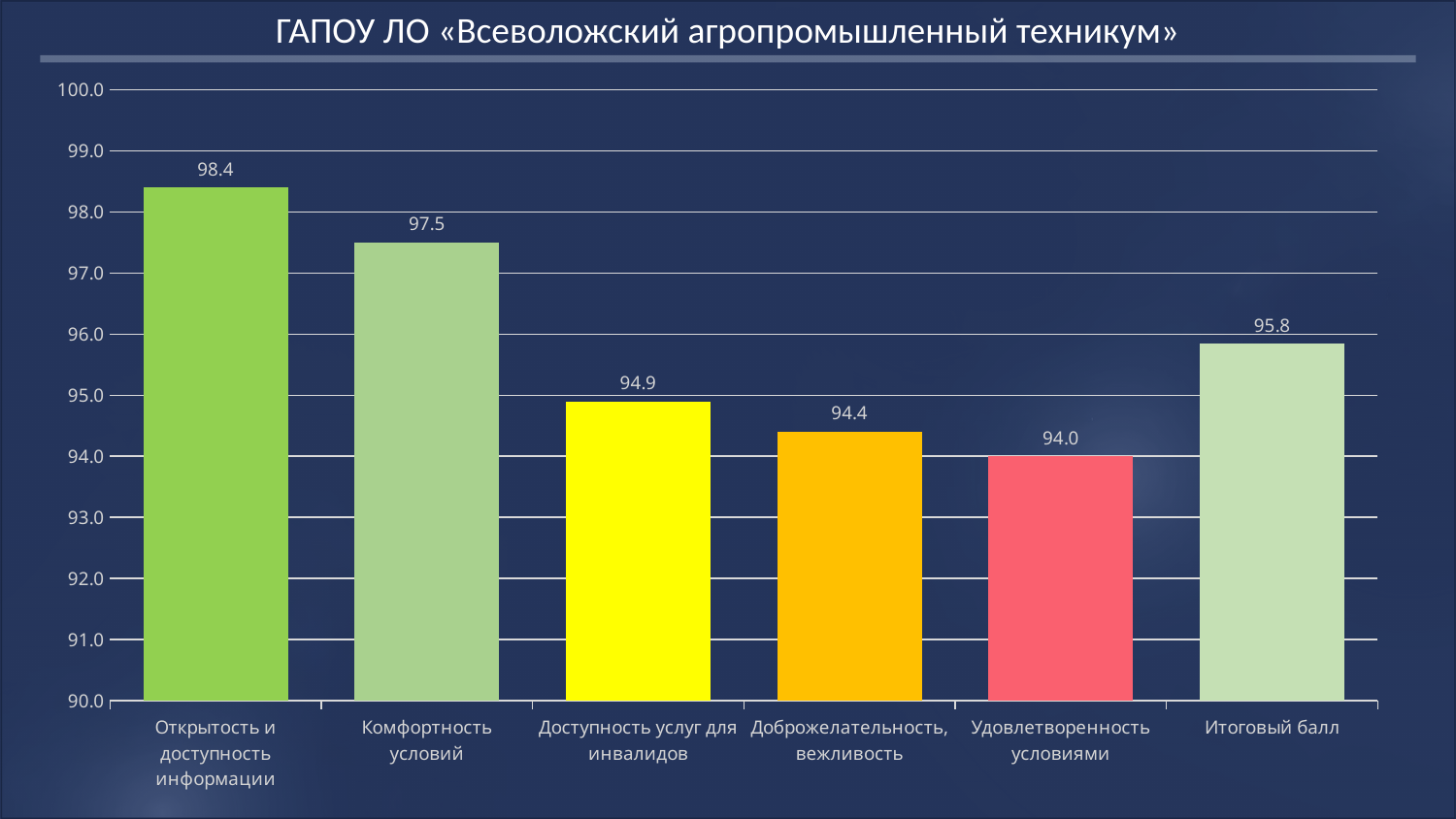
How many categories are shown on the chart? 6 What kind of chart is shown on the slide? Bar chart Which category has the highest value? Открытость и доступность информации What is the value for «Открытость и доступность информации»? 98.4 What is the title of the chart? ГАПОУ ЛО «Всеволожский агропромышленный техникум» What is the value for «Комфортность условий»? 97.5 What is the value for «Удовлетворенность условиями»? 94.0 Which category has the lowest value? Удовлетворенность условиями What is the value for «Итоговый балл»? 95.8 What is the difference between the values for «Открытость и доступность информации» and «Комфортность условий»? 0.9 Which is larger: the value for «Доброжелательность, вежливость» or the value for «Итоговый балл»? Итоговый балл What is the value for «Доступность услуг для инвалидов»? 94.9